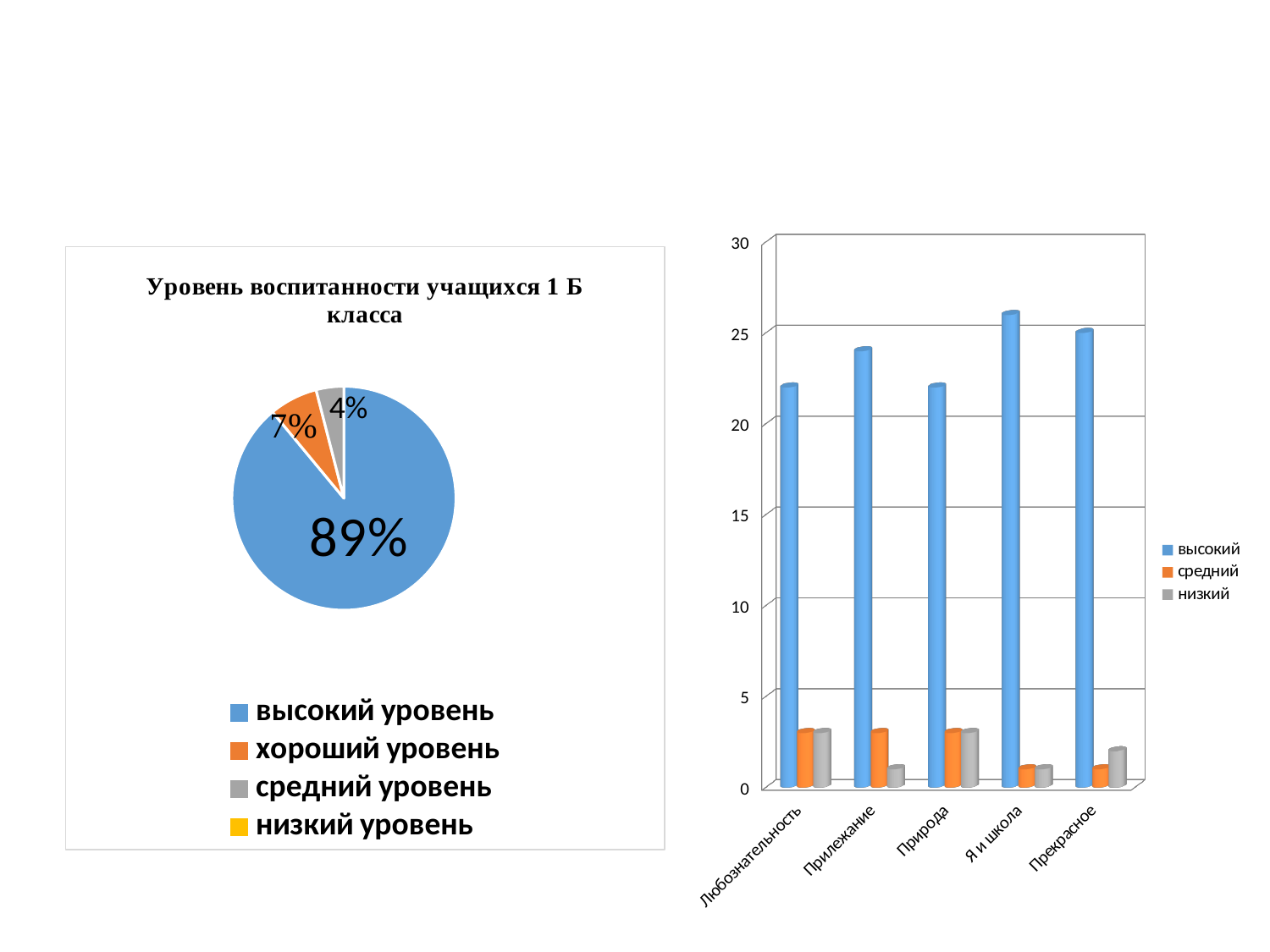
In the bar chart on the right, is the 'средний' value for Любознательность greater or less than 5? less In the bar chart on the right, how many series does the legend list? 3 What kind of chart is the chart on the right of the slide? bar chart In the bar chart on the right, is the 'высокий' value for Прилежание greater or less than 20? greater In the pie chart 'Уровень воспитанности учащихся 1 Б класса', what share does the 'средний уровень' slice have? 4% In the pie chart 'Уровень воспитанности учащихся 1 Б класса', which level has the largest slice? высокий уровень In the bar chart on the right, which is larger for the 'высокий' series: Я и школа or Природа? Я и школа In the pie chart 'Уровень воспитанности учащихся 1 Б класса', what share does the 'хороший уровень' slice have? 7% In the pie chart 'Уровень воспитанности учащихся 1 Б класса', how many entries does the legend list? 4 In the pie chart 'Уровень воспитанности учащихся 1 Б класса', what share does the 'высокий уровень' slice have? 89% What kind of chart is the chart on the left of the slide? pie chart In the bar chart on the right, how many categories are shown on the x axis? 5